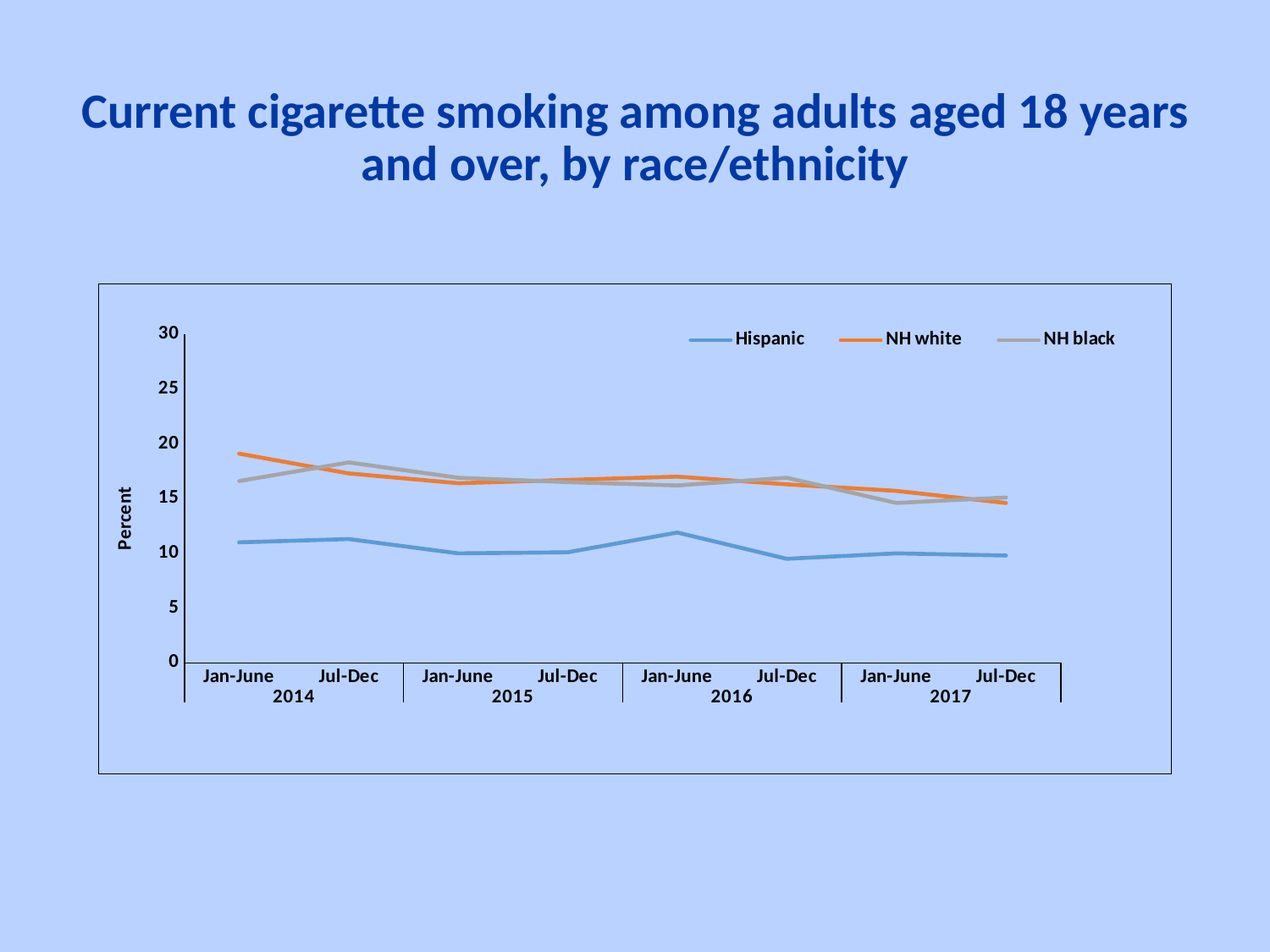
Does the NH white line rise or fall from Jan-June 2014 to Jul-Dec 2017? Fall How many time points are plotted along the x axis? 8 Is the value for Hispanic at Jul-Dec 2016 greater or less than 10? less How many series does the legend list? 3 Is the value for NH white at Jan-June 2014 greater or less than 20? less Which series has the highest value at Jan-June 2014? NH white What is the label on the y axis? Percent Which series has the lowest values across all time points? Hispanic Is the value for Hispanic at Jan-June 2016 greater or less than 10? greater At Jan-June 2017, which is larger: the value for NH black or the value for Hispanic? NH black At Jul-Dec 2014, which is larger: the value for NH black or the value for NH white? NH black What kind of chart is shown on the slide? Line chart